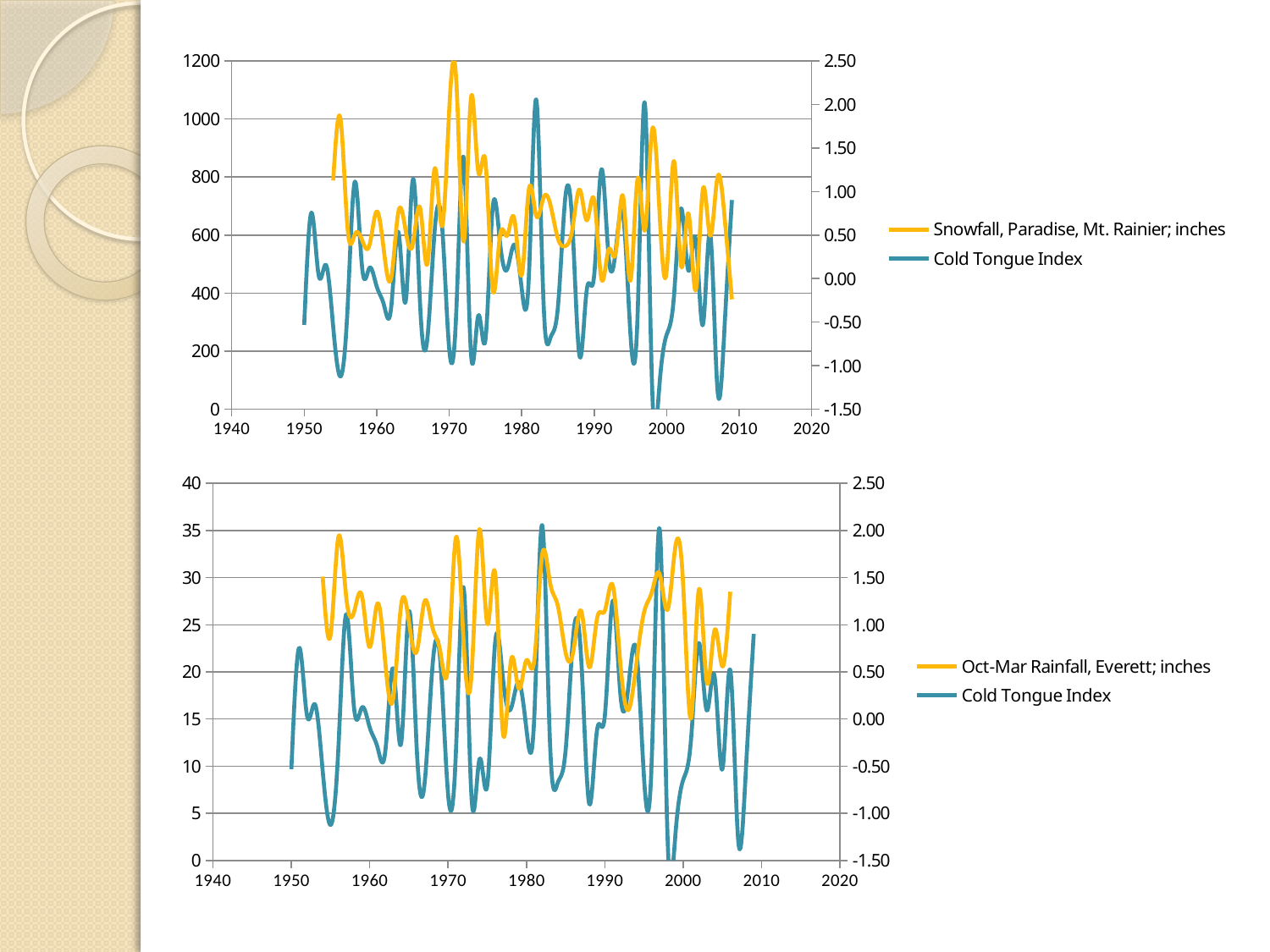
In the bottom chart, which series is drawn in blue? Cold Tongue Index What kind of chart is the top chart on the slide? line chart What kind of chart is the bottom chart on the slide? line chart How many series does the legend of the top chart list? 2 In the bottom chart, is the Oct-Mar Rainfall peak around 1956 greater or less than 30 inches? greater In the top chart, is the Cold Tongue Index peak around 1982 greater or less than 1.50? greater In the top chart, which series is drawn in yellow? Snowfall, Paradise, Mt. Rainier; inches In the bottom chart, is the Cold Tongue Index peak around 1997 greater or less than 1.50? greater How many series does the legend of the bottom chart list? 2